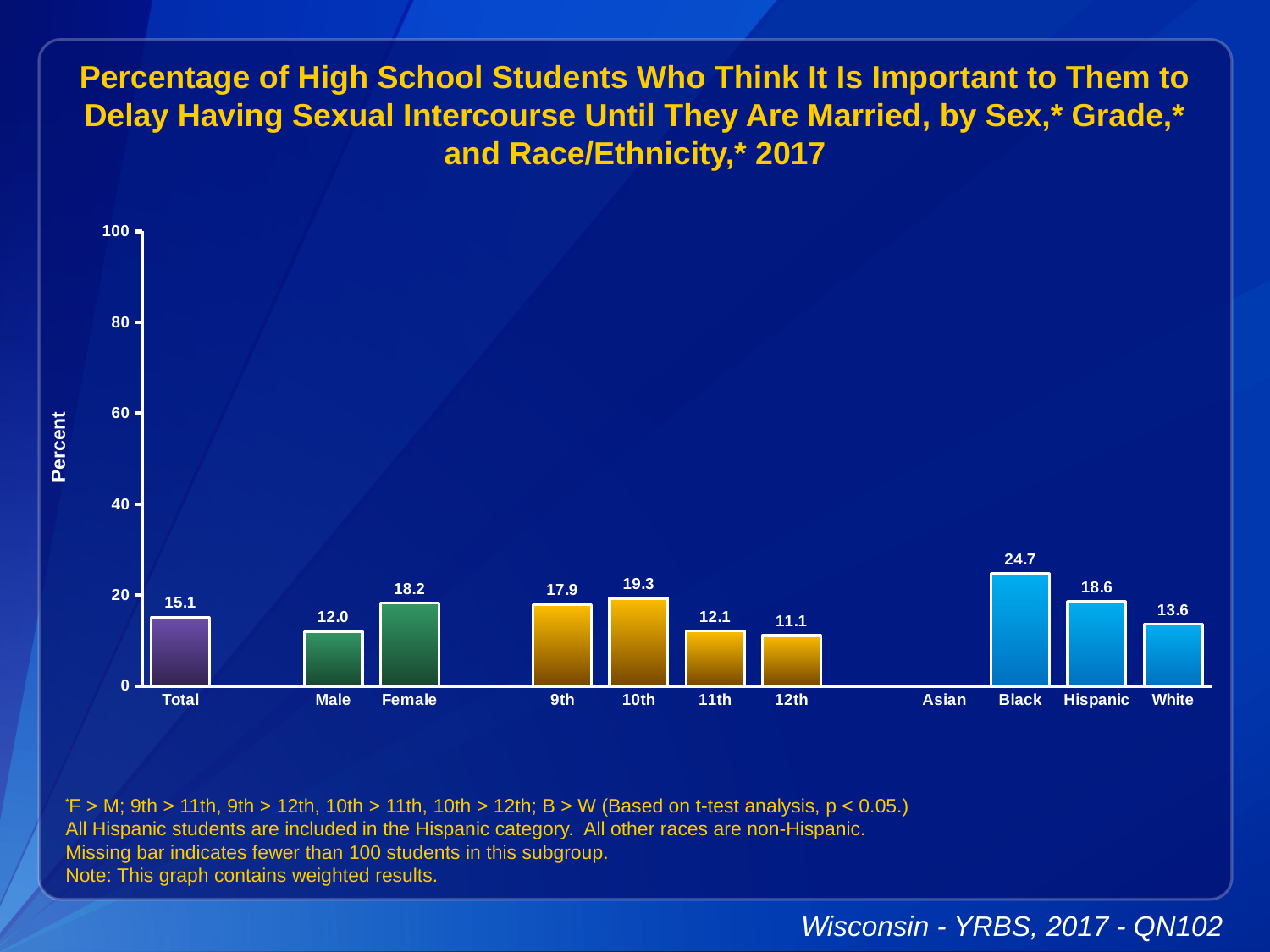
Which category with a plotted bar has the lowest value? 12th What is the difference between the Female and Male values? 6.2 What is the value for Female? 18.2 Which category has the highest value? Black What is the label on the y axis? Percent What kind of chart is shown? bar chart Which is larger, the value for 9th grade or the value for 11th grade? 9th Is the value for Hispanic greater or less than 20? less What is the difference between the Black and White values? 11.1 What is the value for Total? 15.1 What is the value for Black students? 24.7 What is the value for 10th grade? 19.3